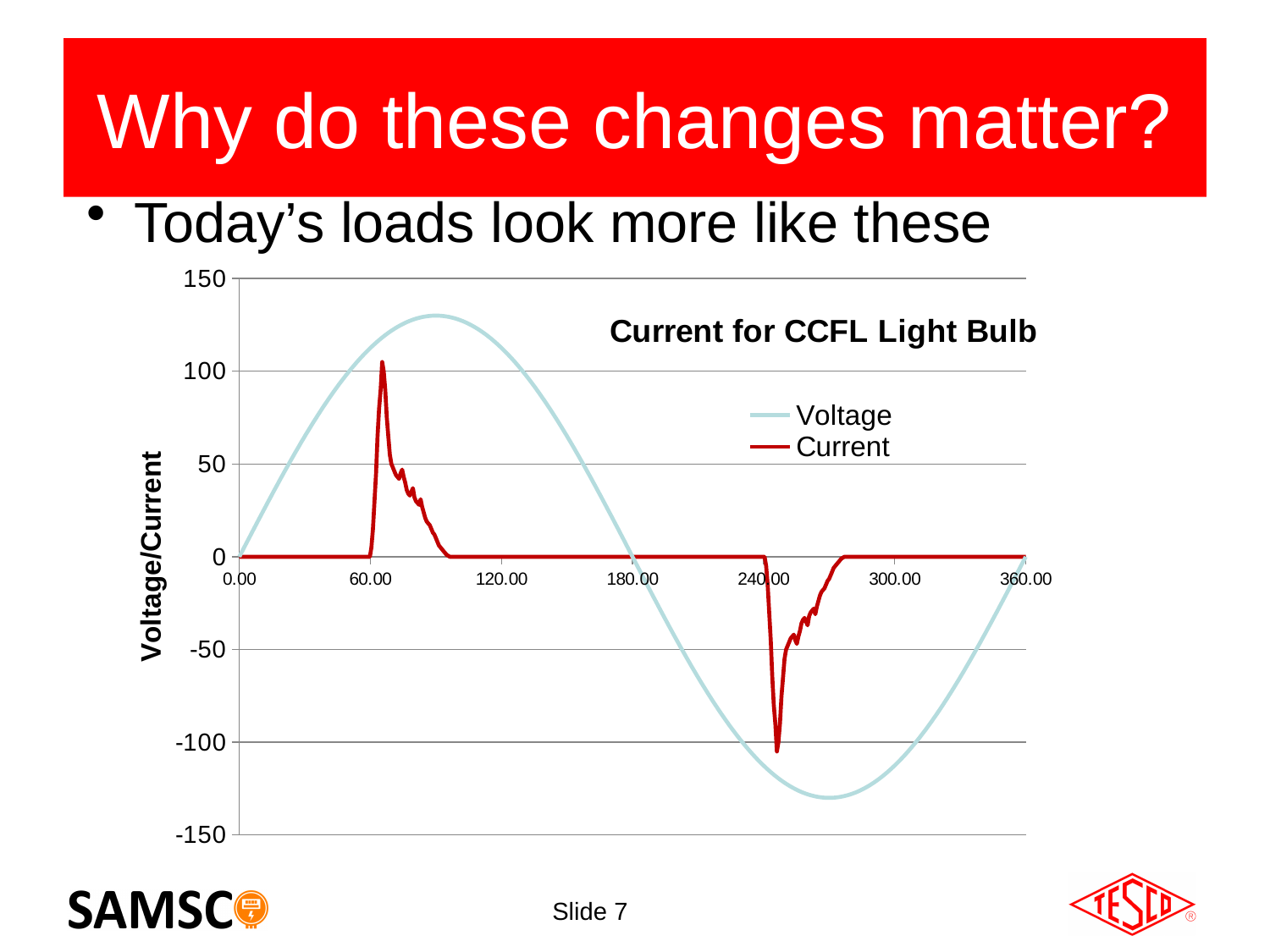
Is the lowest value of the Voltage series greater or less than -100? less Is the peak value of the Voltage series greater or less than 100? greater How many series does the legend list? 2 Does the Voltage series rise or fall between 120.00 and 240.00 on the x axis? fall What is the label of the vertical axis? Voltage/Current What is the title of the chart? Current for CCFL Light Bulb What kind of chart is shown on the slide? Line chart Is the peak value of the Current series greater or less than 150? less Which series reaches the higher peak value, Voltage or Current? Voltage Does the Voltage series rise or fall between 0.00 and 60.00 on the x axis? rise What is the value of the Current series at 120.00 on the x axis? 0 What is the value of the Voltage series at 180.00 on the x axis? 0